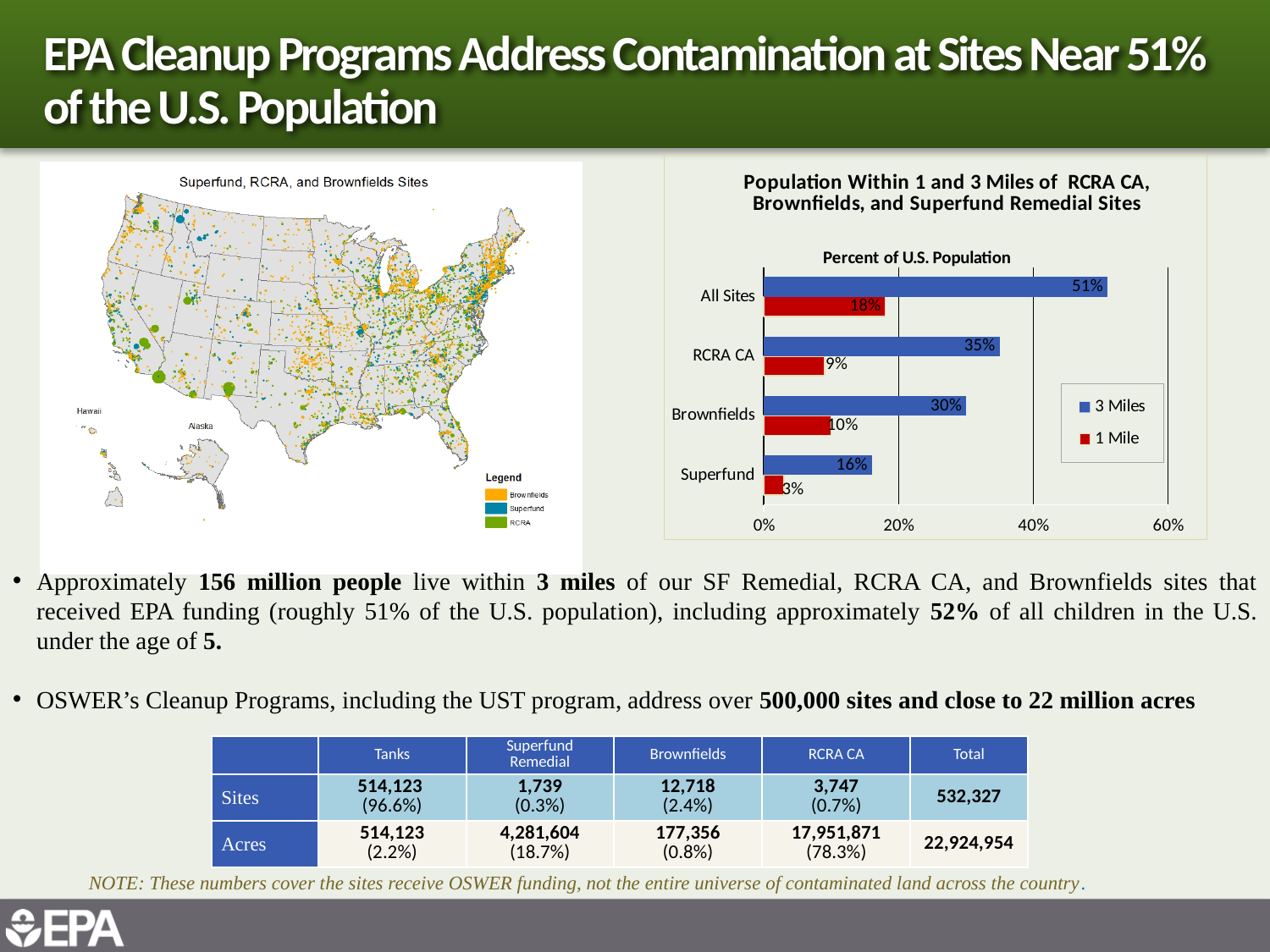
What type of chart is used to show the percent of U.S. population near sites? Bar chart In the bar chart, what is the difference between the 3 Miles and 1 Mile values for All Sites? 33% In the bar chart, which colour represents the 1 Mile series? Red In the bar chart, what is the 3 Miles value for Brownfields? 30% How many categories are shown on the bar chart? 4 In the bar chart, what is the 1 Mile value for Superfund? 3% In the bar chart, which category has the lowest 3 Miles value? Superfund How many series does the bar chart's legend list? 2 In the bar chart, which category has the highest 1 Mile value? All Sites In the bar chart, which is larger: the 1 Mile value for Brownfields or the 1 Mile value for RCRA CA? Brownfields In the bar chart, what percent of the U.S. population lives within 3 miles of All Sites? 51% In the bar chart, what percent of the U.S. population lives within 1 mile of RCRA CA sites? 9%